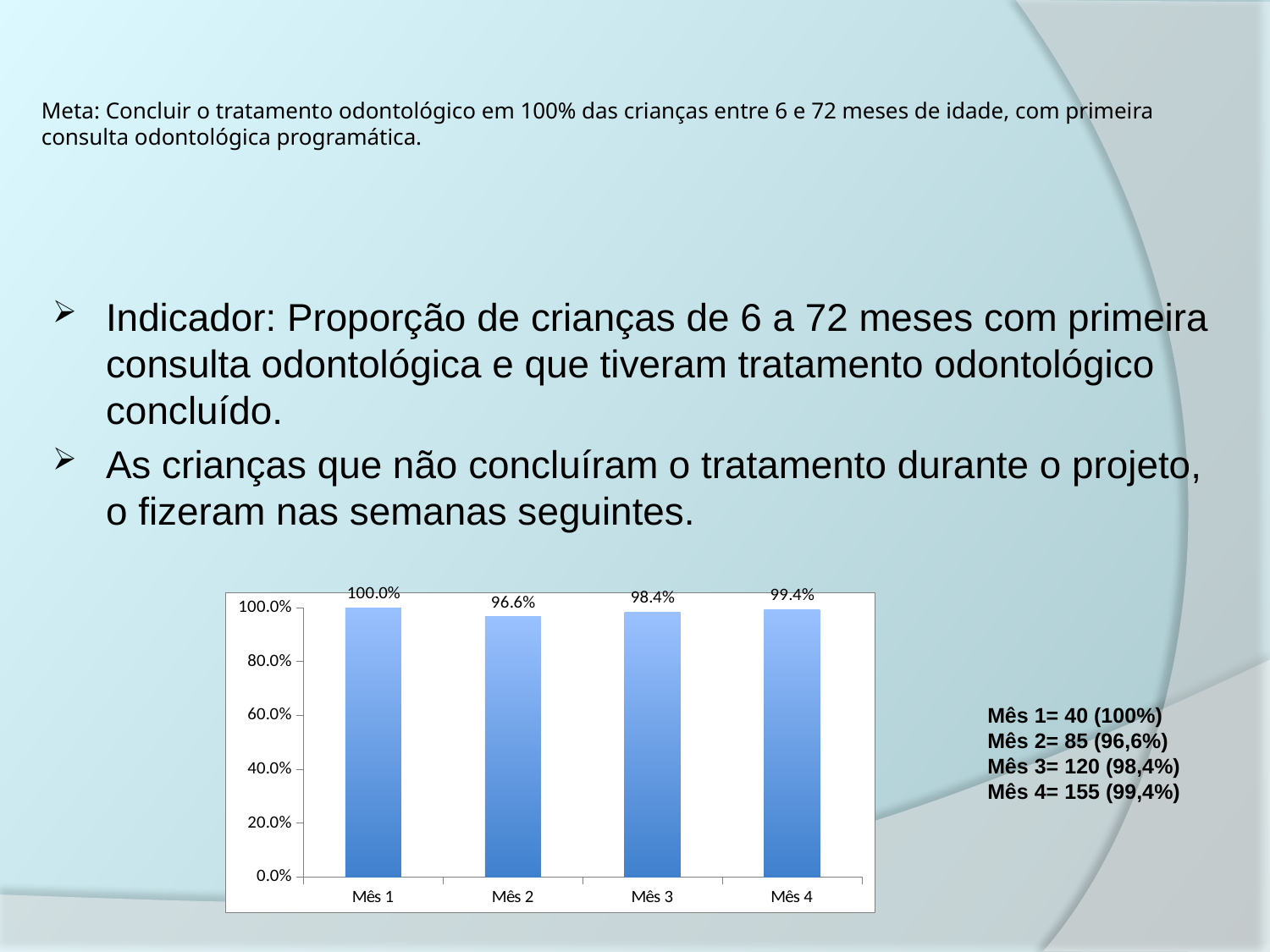
What is the difference between the values for Mês 4 and Mês 3? 1.0% What is the value for Mês 1? 100.0% What is the value for Mês 2? 96.6% What is the difference between the values for Mês 1 and Mês 2? 3.4% Which is larger, the value for Mês 3 or the value for Mês 4? Mês 4 What kind of chart is shown on the slide? Bar chart What is the value for Mês 3? 98.4% What is the value for Mês 4? 99.4% Which month has the lowest value? Mês 2 Is the value for Mês 2 greater or less than 80.0%? greater How many months are shown on the x axis? 4 Which month has the highest value? Mês 1